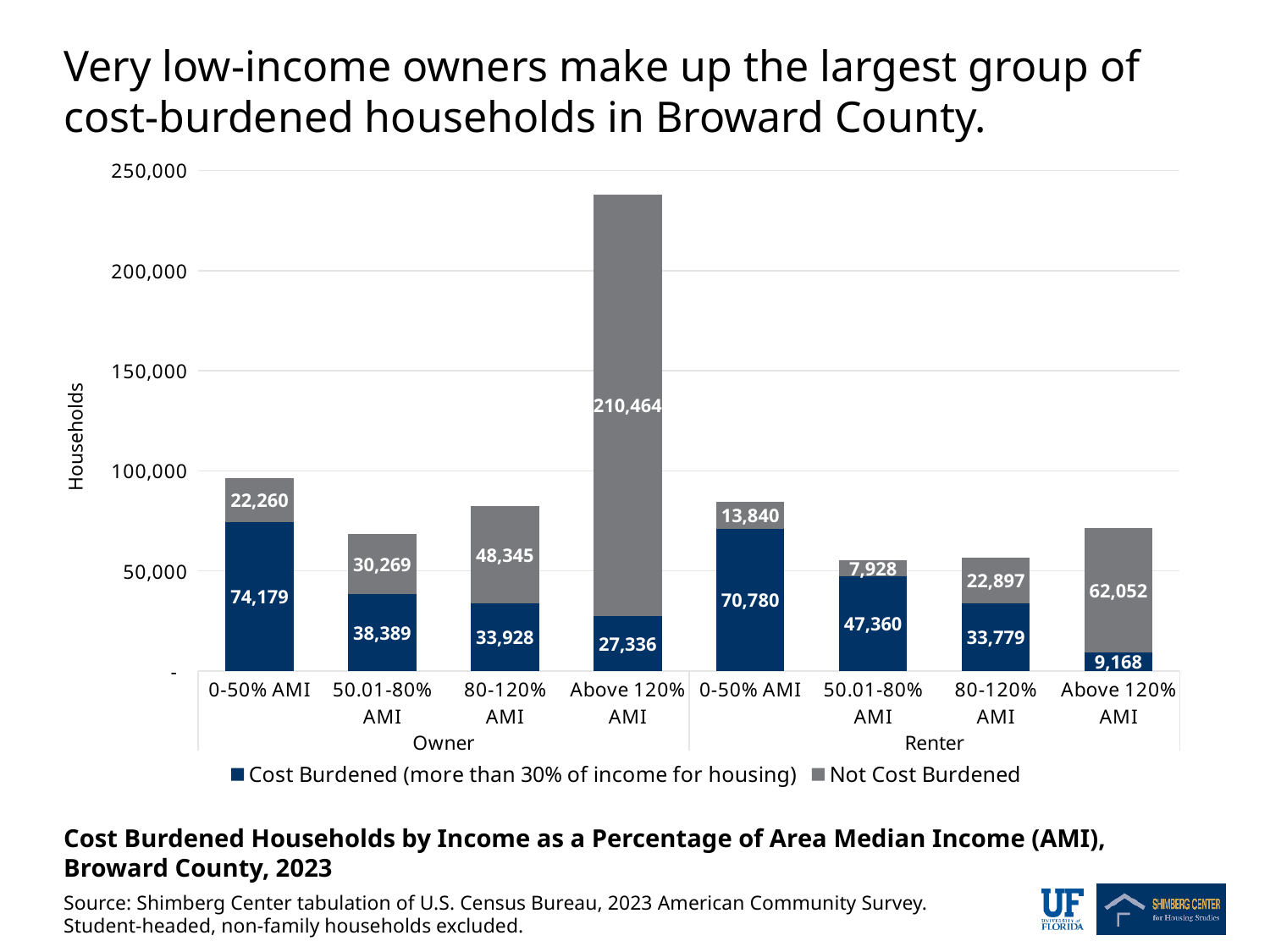
What is the number of not cost-burdened renter households in the Above 120% AMI group? 62,052 Which is larger: the number of not cost-burdened owner households in the 80-120% AMI group or the number of not cost-burdened renter households in the 80-120% AMI group? Owner 80-120% AMI What is the number of not cost-burdened owner households in the Above 120% AMI group? 210,464 What is the total number of households in the Owner Above 120% AMI bar? 237,800 How many income group bars are shown in the chart? 8 What type of chart is shown on the slide? Stacked bar chart Which income group has the lowest number of cost-burdened households? Renter Above 120% AMI How many series does the legend list? 2 Which income group has the highest number of cost-burdened households? Owner 0-50% AMI What is the number of cost-burdened owner households in the 0-50% AMI group? 74,179 What is the difference between cost-burdened owner households and cost-burdened renter households in the 0-50% AMI group? 3,399 What is the number of cost-burdened renter households in the 50.01-80% AMI group? 47,360